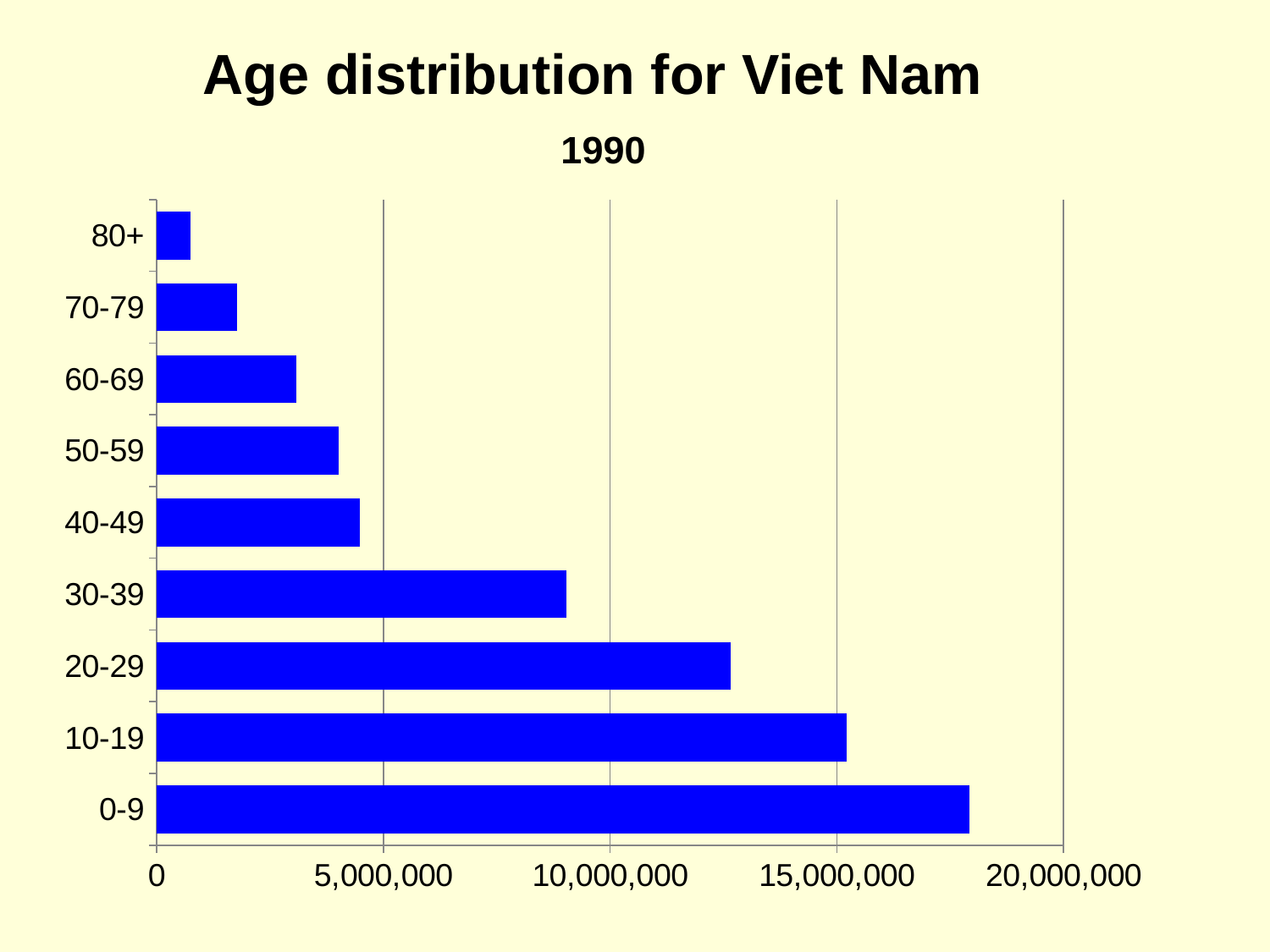
What is the title of the chart? 1990 Which age group has the lowest value? 80+ Is the value for the 0-9 age group greater or less than 15,000,000? greater Is the value for the 40-49 age group greater or less than 5,000,000? less Is the value for the 30-39 age group greater or less than 10,000,000? less Which year does the chart show data for? 1990 Which age group has the larger value, 60-69 or 70-79? 60-69 How many age groups are plotted on the chart? 9 Which age group has the highest value? 0-9 Which age group has the larger value, 20-29 or 30-39? 20-29 What kind of chart is shown on the slide? bar chart